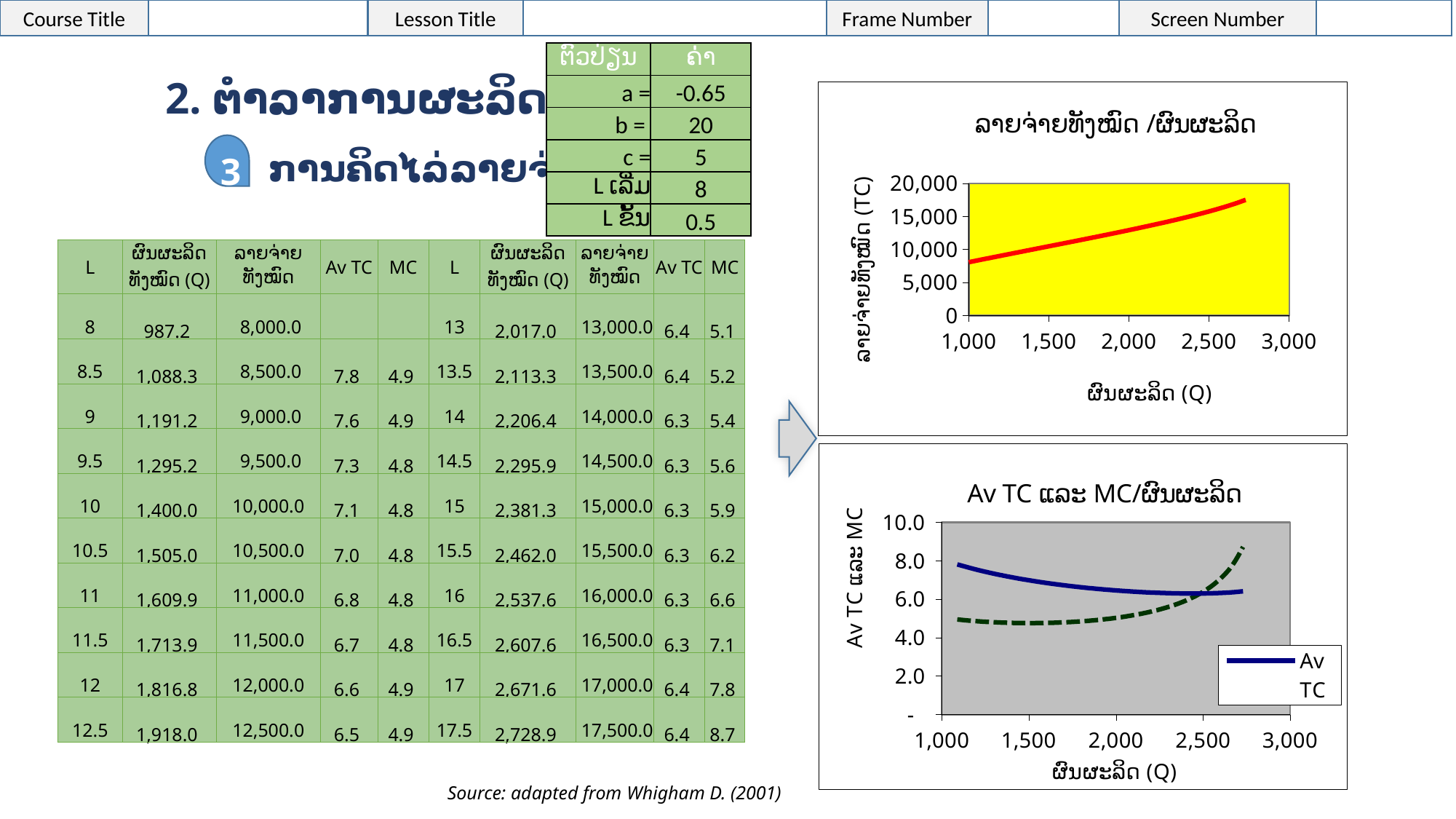
In the top-right chart 'ລາຍຈ່າຍທັງໝົດ /ຜົນຜະລິດ', does the red line rise or fall as Q increases? rise In the top-right chart 'ລາຍຈ່າຍທັງໝົດ /ຜົນຜະລິດ', is the value at Q = 2,000 greater or less than 15,000? less What kind of chart is the top-right chart titled 'ລາຍຈ່າຍທັງໝົດ /ຜົນຜະລິດ'? line chart In the bottom-right chart 'Av TC ແລະ MC/ຜົນຜະລິດ', does the dashed MC line rise or fall as Q increases? rise What kind of chart is the bottom-right chart titled 'Av TC ແລະ MC/ຜົນຜະລິດ'? line chart In the bottom-right chart 'Av TC ແລະ MC/ຜົນຜະລິດ', does the solid Av TC line generally rise or fall as Q increases? fall In the bottom-right chart 'Av TC ແລະ MC/ຜົນຜະລິດ', is the MC (dashed line) value at the right end of the line greater or less than 8.0? greater In the bottom-right chart 'Av TC ແລະ MC/ຜົນຜະລິດ', is the MC (dashed line) value at Q = 1,500 greater or less than 6.0? less What is the x-axis title of the top-right chart 'ລາຍຈ່າຍທັງໝົດ /ຜົນຜະລິດ'? ຜົນຜະລິດ (Q) In the bottom-right chart 'Av TC ແລະ MC/ຜົນຜະລິດ', which line is higher at Q = 1,500, Av TC or MC? Av TC